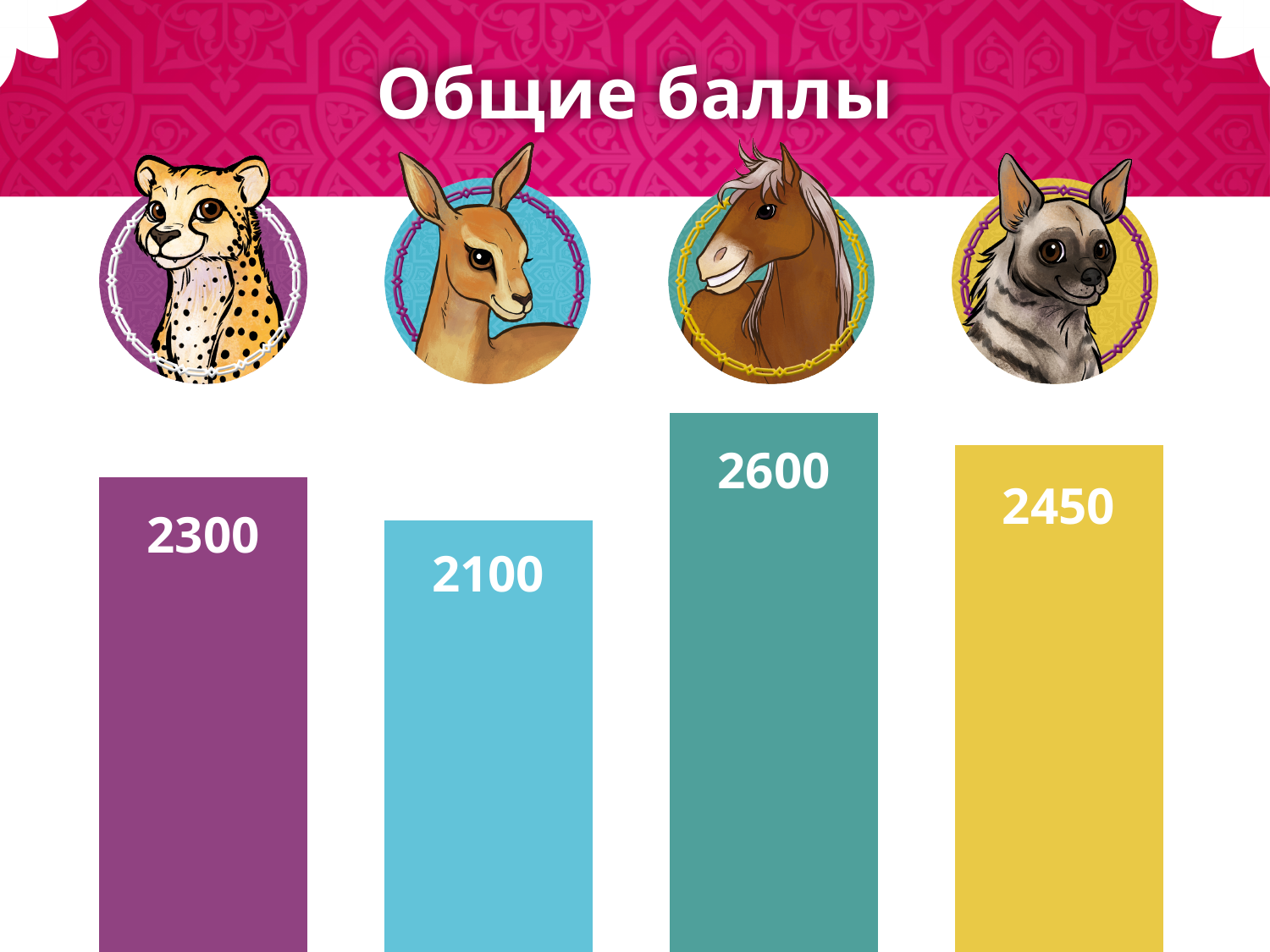
Which bar has the lowest value? The second bar (light blue, 2100) How many bars are shown in the chart? 4 What kind of chart is shown on the slide? Bar chart What is the value of the third bar from the left (teal bar)? 2600 What is the value of the first bar from the left (purple bar)? 2300 Which is larger, the value of the first bar or the value of the fourth bar? The fourth bar (2450) Which bar has the highest value? The third bar (teal, 2600) What is the difference between the fourth bar (2450) and the first bar (2300)? 150 What is the value of the second bar from the left (light blue bar)? 2100 What is the value of the fourth bar from the left (yellow bar)? 2450 What is the title of the chart? Общие баллы What is the difference between the highest and lowest bar values? 500